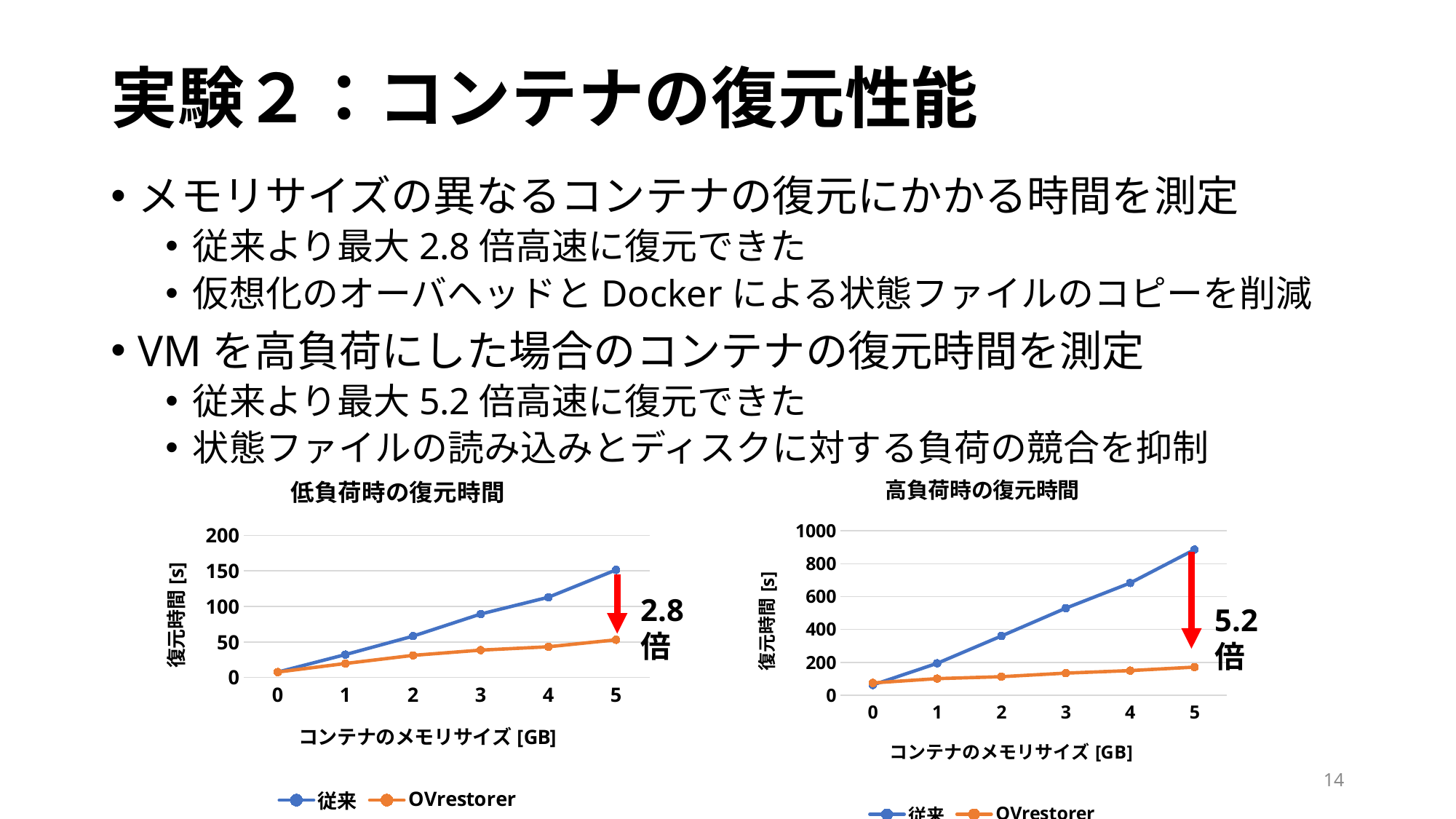
In the left chart (低負荷時の復元時間), how many memory-size points are plotted along the x axis? 6 What is the y-axis label of the left chart (低負荷時の復元時間)? 復元時間 [s] In the right chart (高負荷時の復元時間), is the 従来 value at 2 GB greater or less than 400? less What is the title of the right chart? 高負荷時の復元時間 In the right chart (高負荷時の復元時間), is the OVrestorer value at 5 GB greater or less than 200? less In the right chart (高負荷時の復元時間), which series has the larger value at 5 GB, 従来 or OVrestorer? 従来 What type of chart is the left chart titled 低負荷時の復元時間? line chart How many series does the legend of the right chart (高負荷時の復元時間) list? 2 In the right chart (高負荷時の復元時間), is the 従来 value at 5 GB greater or less than 800? greater In the right chart (高負荷時の復元時間), does the 従来 line rise or fall as the container memory size increases? rises